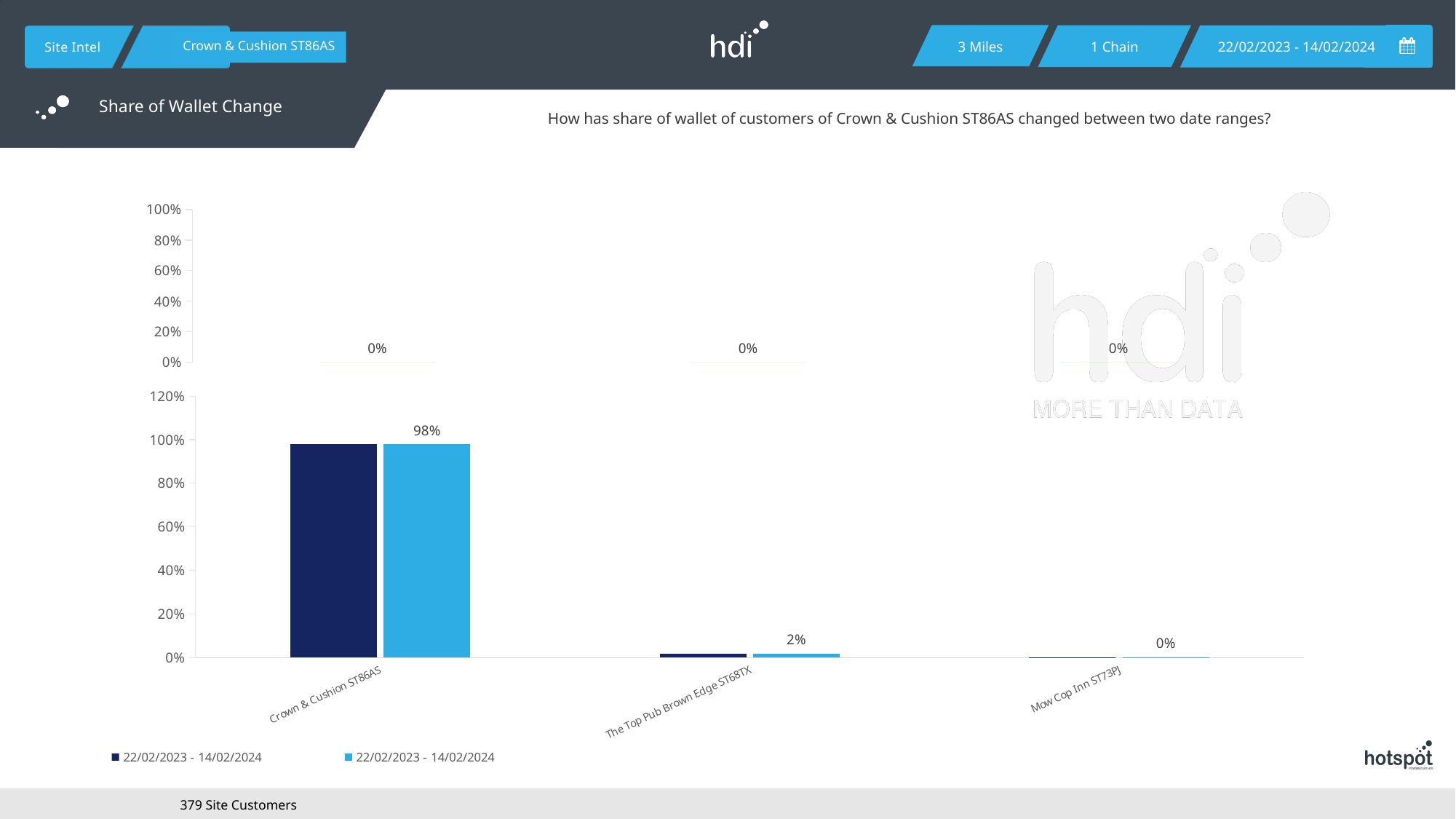
On the bottom chart, what is the data label shown for The Top Pub Brown Edge ST68TX? 2% On the bottom chart, which category has the lowest share of wallet? Mow Cop Inn ST73PJ On the bottom chart, is the value for The Top Pub Brown Edge ST68TX greater or less than 20%? less On the bottom chart, which category has the highest share of wallet? Crown & Cushion ST86AS On the bottom chart, what is the data label shown for Mow Cop Inn ST73PJ? 0% What kind of chart is the bottom chart? bar chart On the bottom chart, what is the data label shown above the bars for Crown & Cushion ST86AS? 98% How many categories are shown on the x axis of the bottom chart? 3 How many series does the legend of the bottom chart list? 2 On the bottom chart, is the value for Crown & Cushion ST86AS greater or less than 80%? greater On the bottom chart, what is the difference between the labelled values for Crown & Cushion ST86AS and The Top Pub Brown Edge ST68TX? 96%